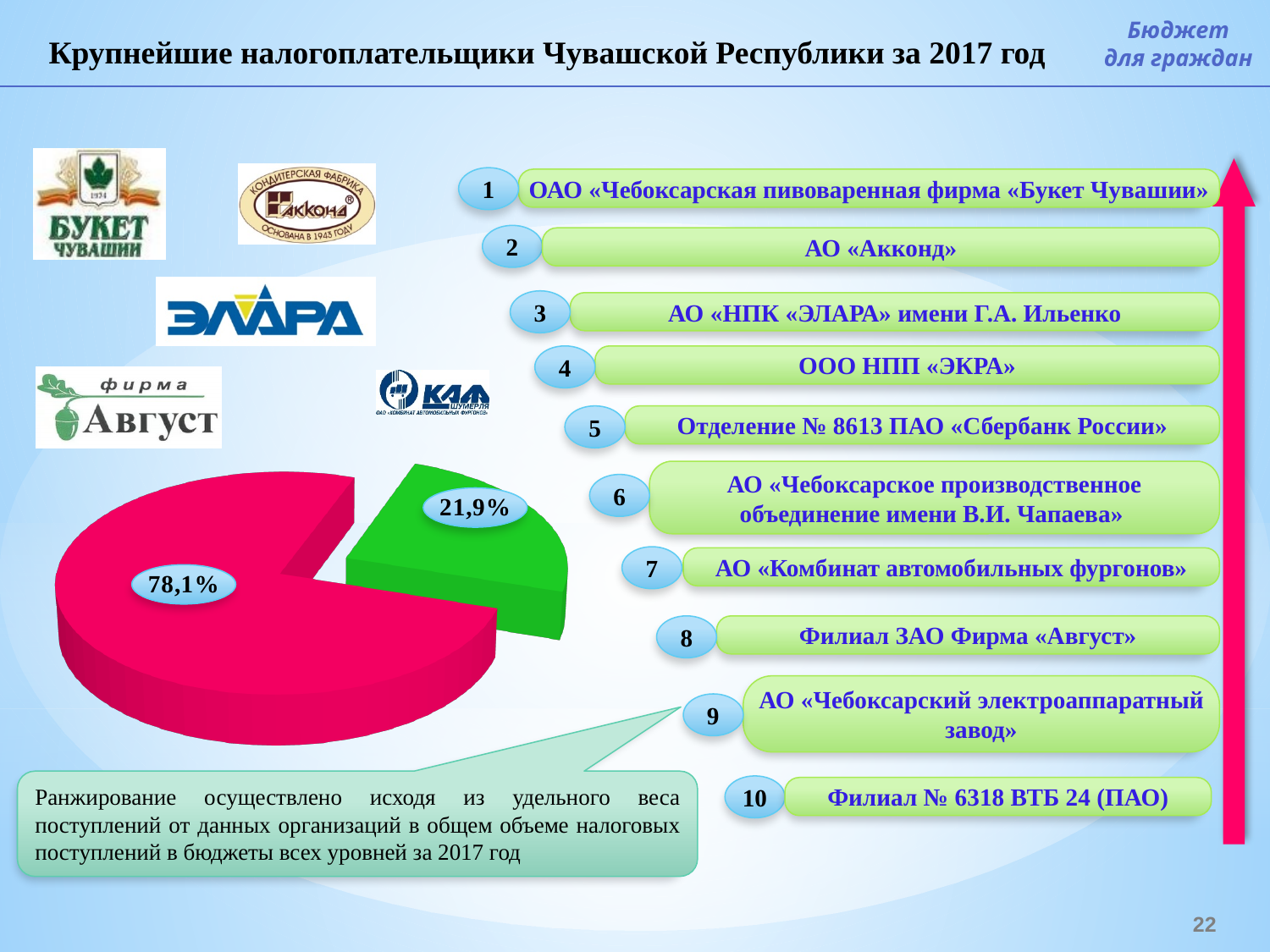
Is the value of the pink slice of the pie chart greater or less than 50%? greater Which slice of the pie chart is pulled out (exploded) from the rest of the pie? the green slice How many slices does the pie chart have? 2 Which is larger in the pie chart, the green slice or the pink slice? the pink slice What value is labelled on the pink slice of the pie chart? 78,1% Is the value of the green slice of the pie chart greater or less than 25%? less Which slice of the pie chart is the smallest? the green slice (21,9%) What kind of chart is shown on the slide? pie chart What is the difference between the pink slice and the green slice of the pie chart? 56,2% What value is labelled on the green slice of the pie chart? 21,9% What share of the pie does the green slice represent? 21,9% Which slice of the pie chart is the largest? the pink slice (78,1%)